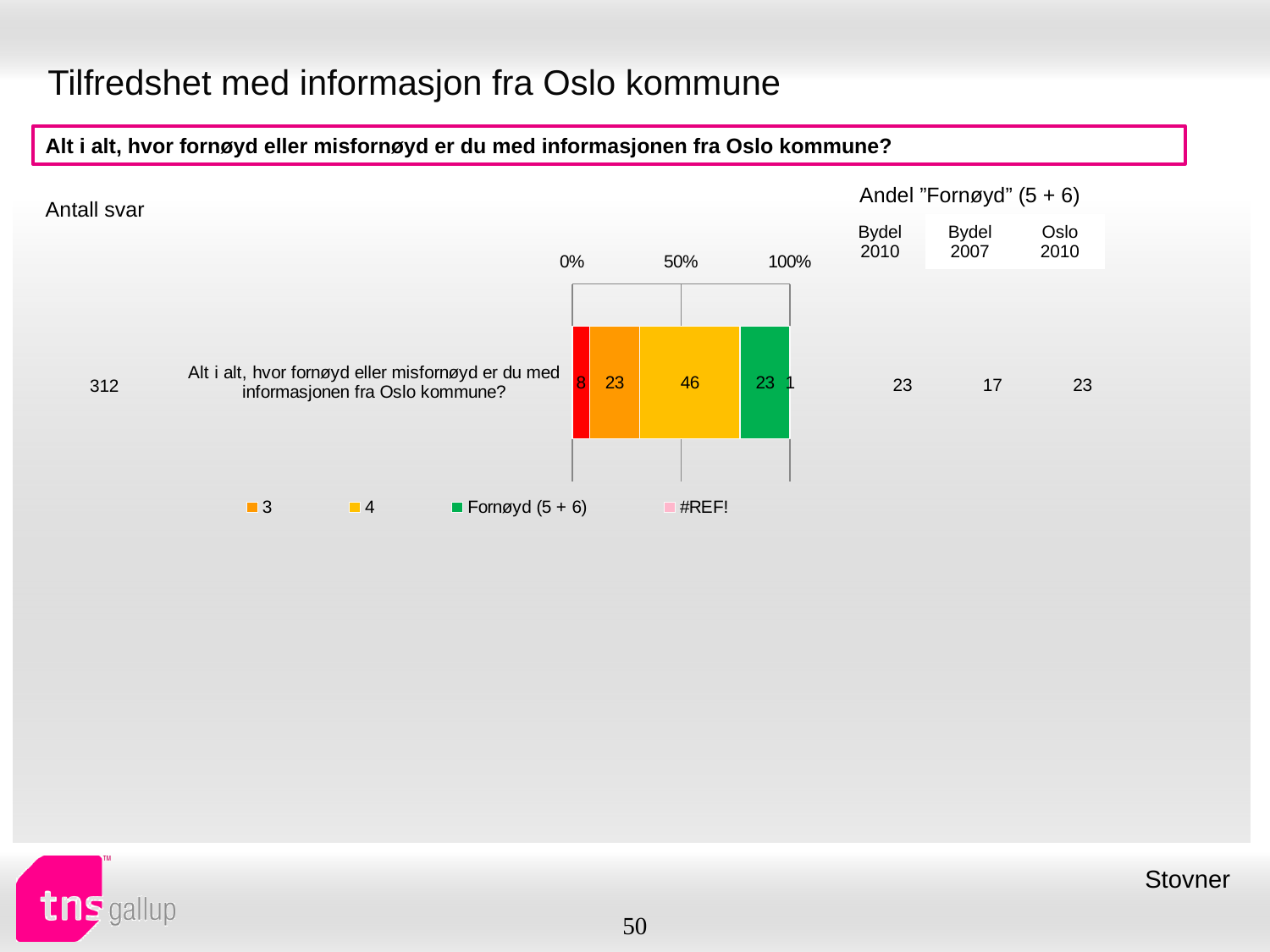
What is the value of the "4" segment in the stacked bar? 46 How many bars does the chart contain? 1 What colour is the "Fornøyd (5 + 6)" series in the chart? green What kind of chart is shown on the slide? bar chart What is the difference between the "4" segment and the "3" segment? 23 Which is larger, the "4" segment or the "Fornøyd (5 + 6)" segment? 4 How many series does the legend list? 4 What is the value of the "#REF!" segment in the stacked bar? 1 Which legend series has the smallest segment in the stacked bar? #REF! Which legend series has the largest segment in the stacked bar? 4 What is the value of the "Fornøyd (5 + 6)" segment in the stacked bar? 23 What is the value of the "3" segment in the stacked bar? 23